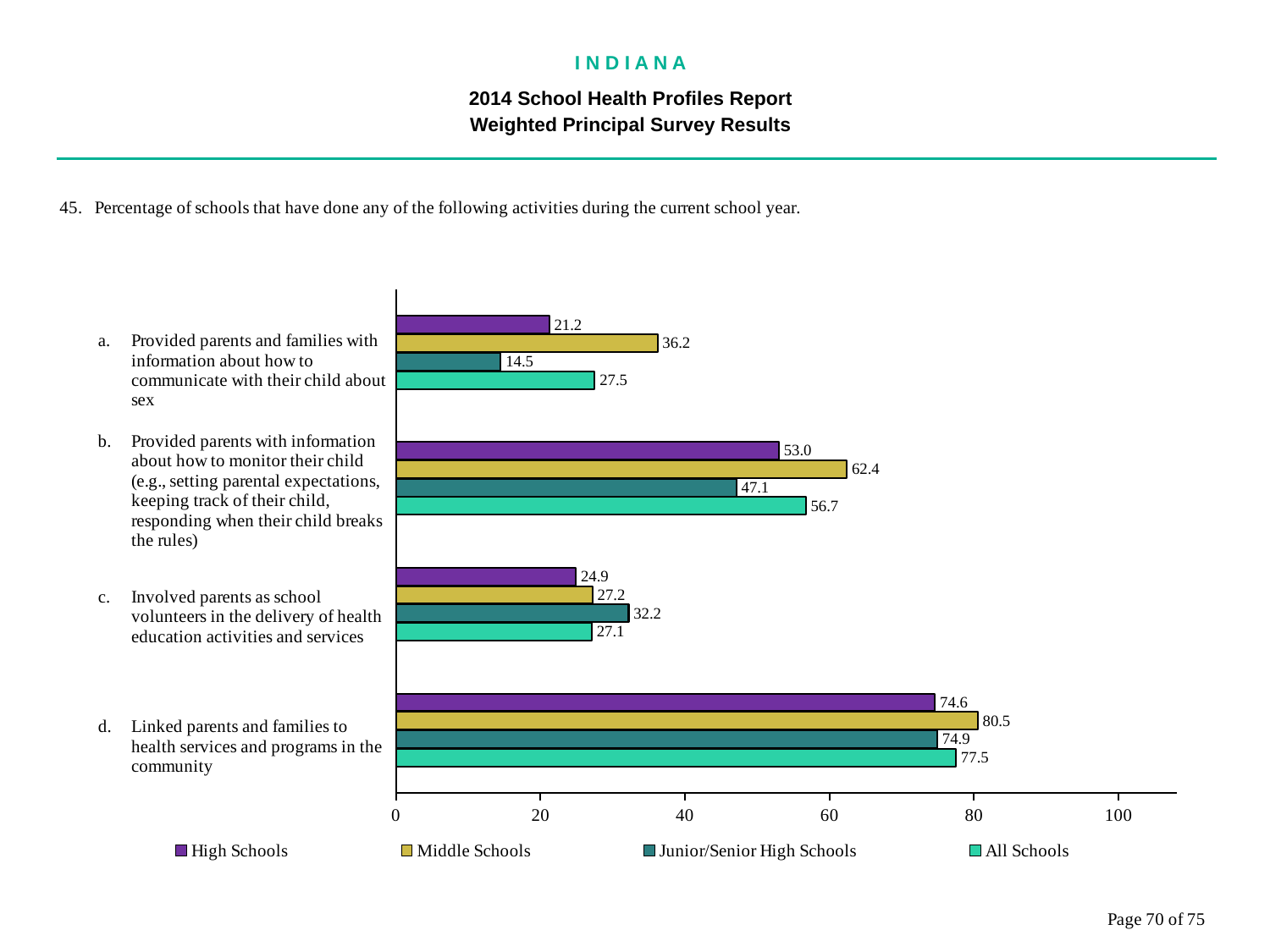
What is the difference between the Middle Schools and High Schools values for activity b (information about how to monitor their child)? 9.4 Which series is shown in yellow in the legend? Middle Schools Which activity has the highest value for High Schools? d. Linked parents and families to health services and programs in the community How many series does the legend list? 4 What is the value for Middle Schools for activity a (provided parents and families with information about how to communicate with their child about sex)? 36.2 Is the Middle Schools value for activity d (linked parents and families to health services) greater or less than 80? greater For activity c (involved parents as school volunteers), which is larger: the Junior/Senior High Schools value or the High Schools value? Junior/Senior High Schools How many activities (categories) are shown on the chart? 4 What is the All Schools value for activity b (provided parents with information about how to monitor their child)? 56.7 What kind of chart is shown on the slide? Bar chart What is the value for Junior/Senior High Schools for activity d (linked parents and families to health services and programs in the community)? 74.9 Which school type has the lowest value for activity a (information about how to communicate with their child about sex)? Junior/Senior High Schools